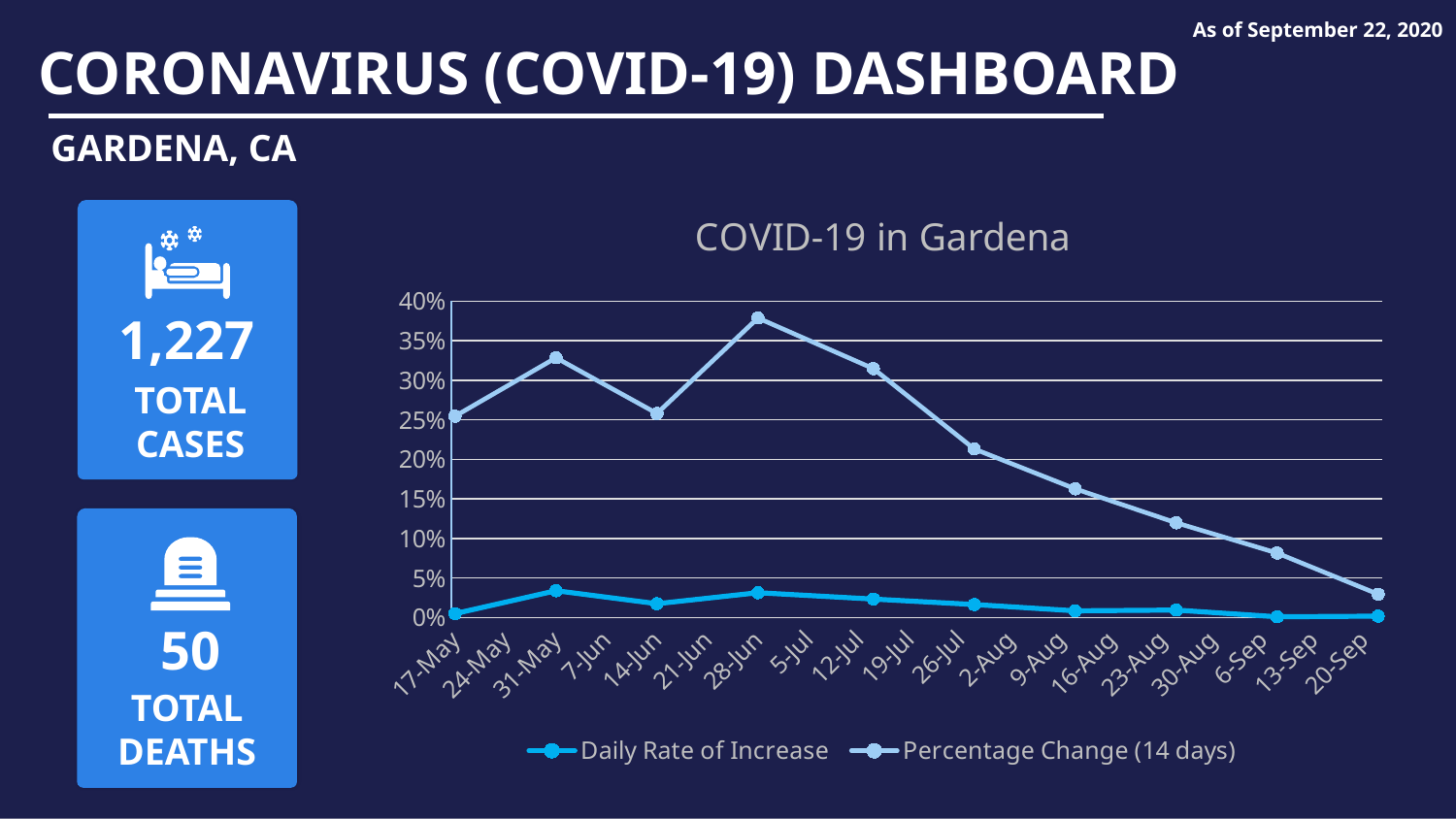
On which date does the Percentage Change (14 days) series reach its lowest value? 20-Sep On which date does the Percentage Change (14 days) series reach its highest value? 28-Jun How many series does the legend of the "COVID-19 in Gardena" chart list? 2 How many date labels are shown on the x axis of the "COVID-19 in Gardena" chart? 19 Is the Percentage Change (14 days) value at 28-Jun greater or less than 35%? greater What kind of chart is "COVID-19 in Gardena"? line chart Which is larger for Percentage Change (14 days): the value at 31-May or the value at 14-Jun? 31-May Is the Daily Rate of Increase value at 31-May greater or less than 5%? less Is the Percentage Change (14 days) value at 9-Aug greater or less than 15%? greater What are the two series named in the legend of the "COVID-19 in Gardena" chart? Daily Rate of Increase; Percentage Change (14 days) From 28-Jun to 20-Sep, does the Percentage Change (14 days) series rise or fall? fall